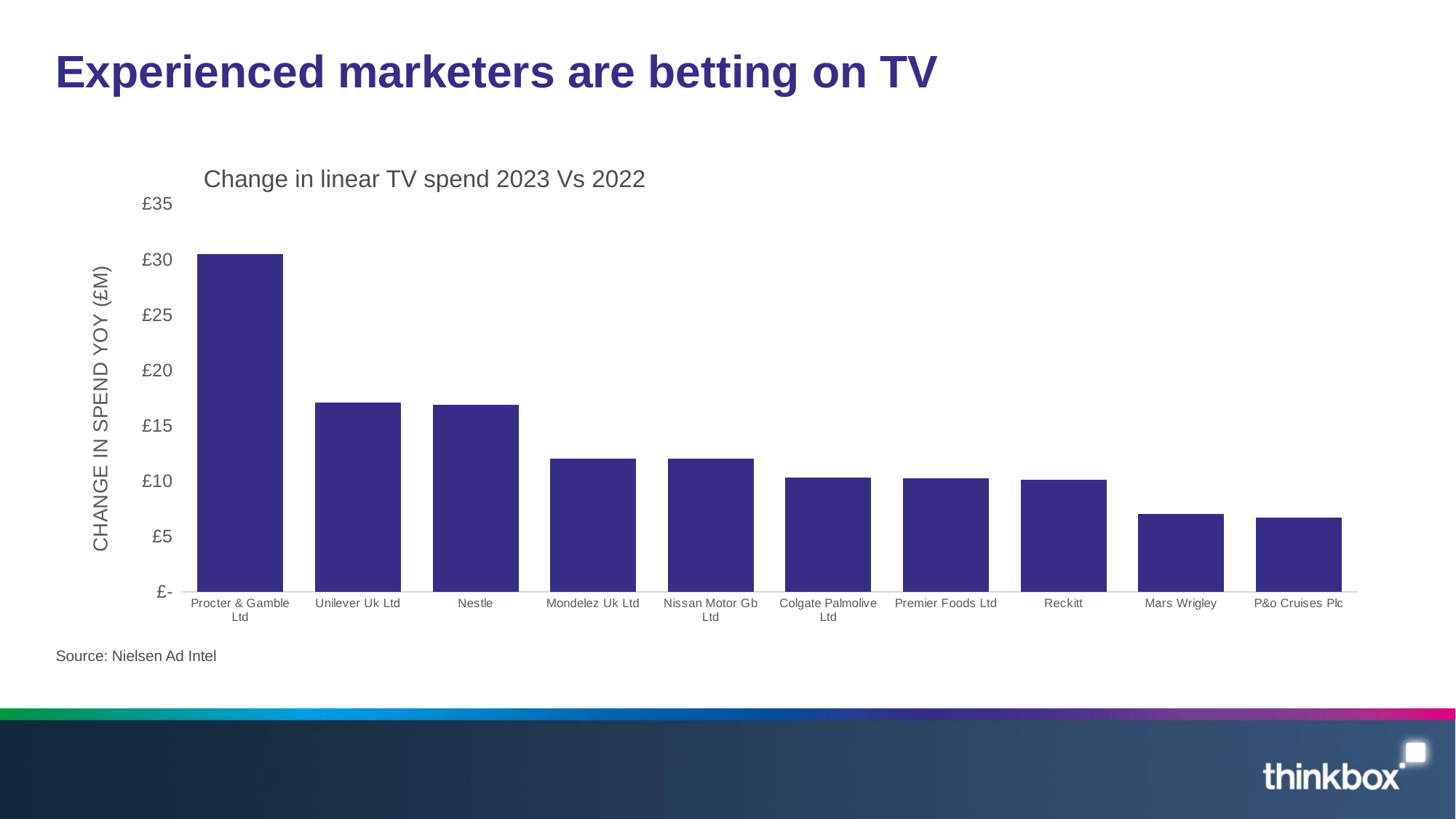
Is the value for Unilever Uk Ltd greater or less than £15? greater Is the value for Procter & Gamble Ltd greater or less than £25? greater What kind of chart is shown on the slide? Bar chart Is the value for Nestle greater or less than £20? less How many companies are shown on the chart? 10 Do the values rise or fall moving from left to right across the chart? Fall Which company has the highest change in linear TV spend? Procter & Gamble Ltd What is the label on the vertical axis of the chart? CHANGE IN SPEND YOY (£M) What is the title of the chart? Change in linear TV spend 2023 Vs 2022 Which is larger, the value for Unilever Uk Ltd or the value for Mondelez Uk Ltd? Unilever Uk Ltd